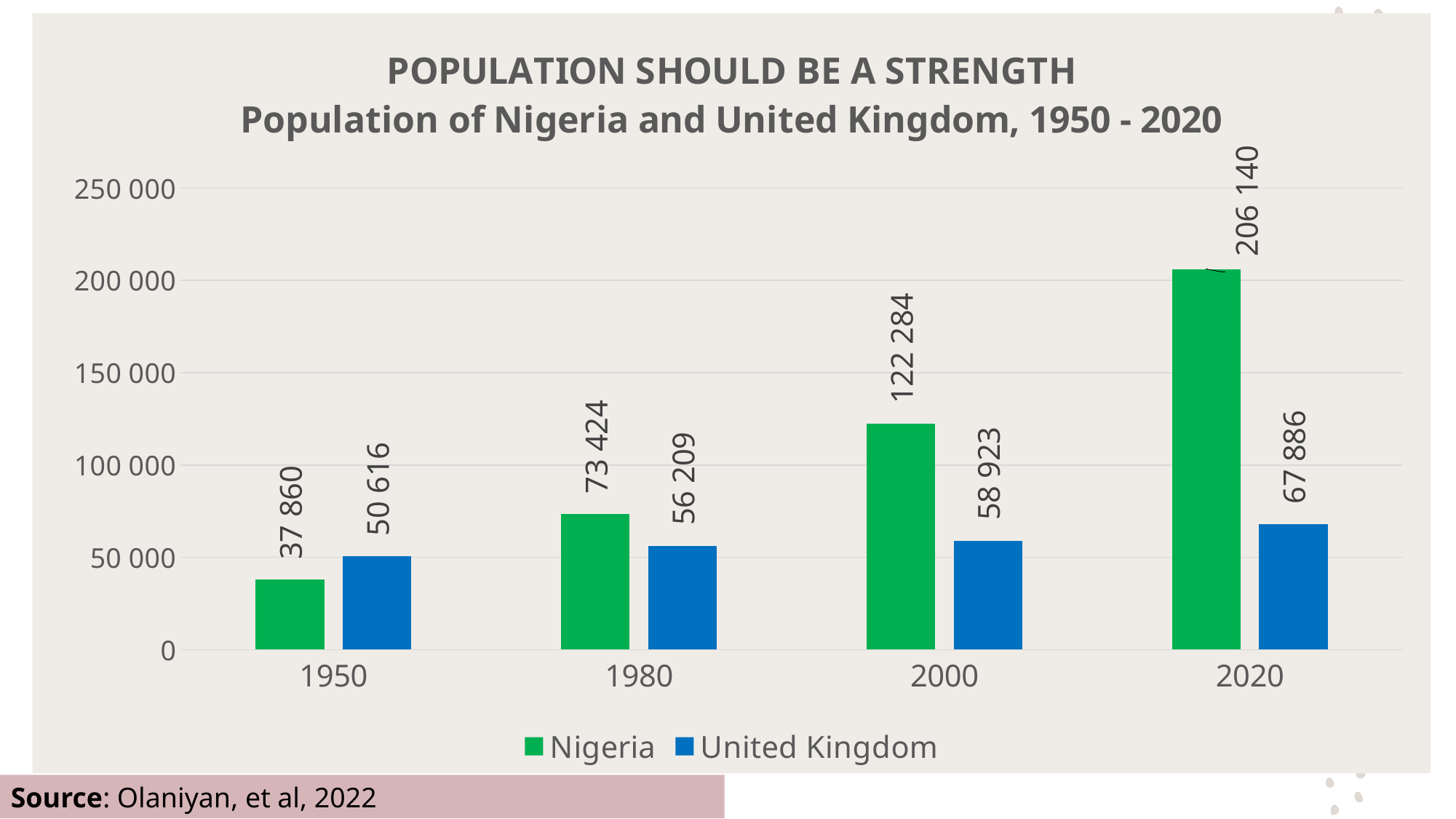
What is the population value shown for the United Kingdom in 1950? 50 616 Do the Nigeria values rise or fall from 1950 to 2020? rise How many years are shown on the x axis? 4 How many series does the legend list? 2 What is the population value shown for Nigeria in 1980? 73 424 What is the population value shown for the United Kingdom in 2000? 58 923 Which is larger in 1950, the Nigeria value or the United Kingdom value? United Kingdom In which year is the Nigeria bar the lowest? 1950 In which year is the United Kingdom bar the highest? 2020 What is the population value shown for Nigeria in 2020? 206 140 What is the difference between the Nigeria and United Kingdom values in 2020? 138 254 What is the difference between the United Kingdom and Nigeria values in 1950? 12 756